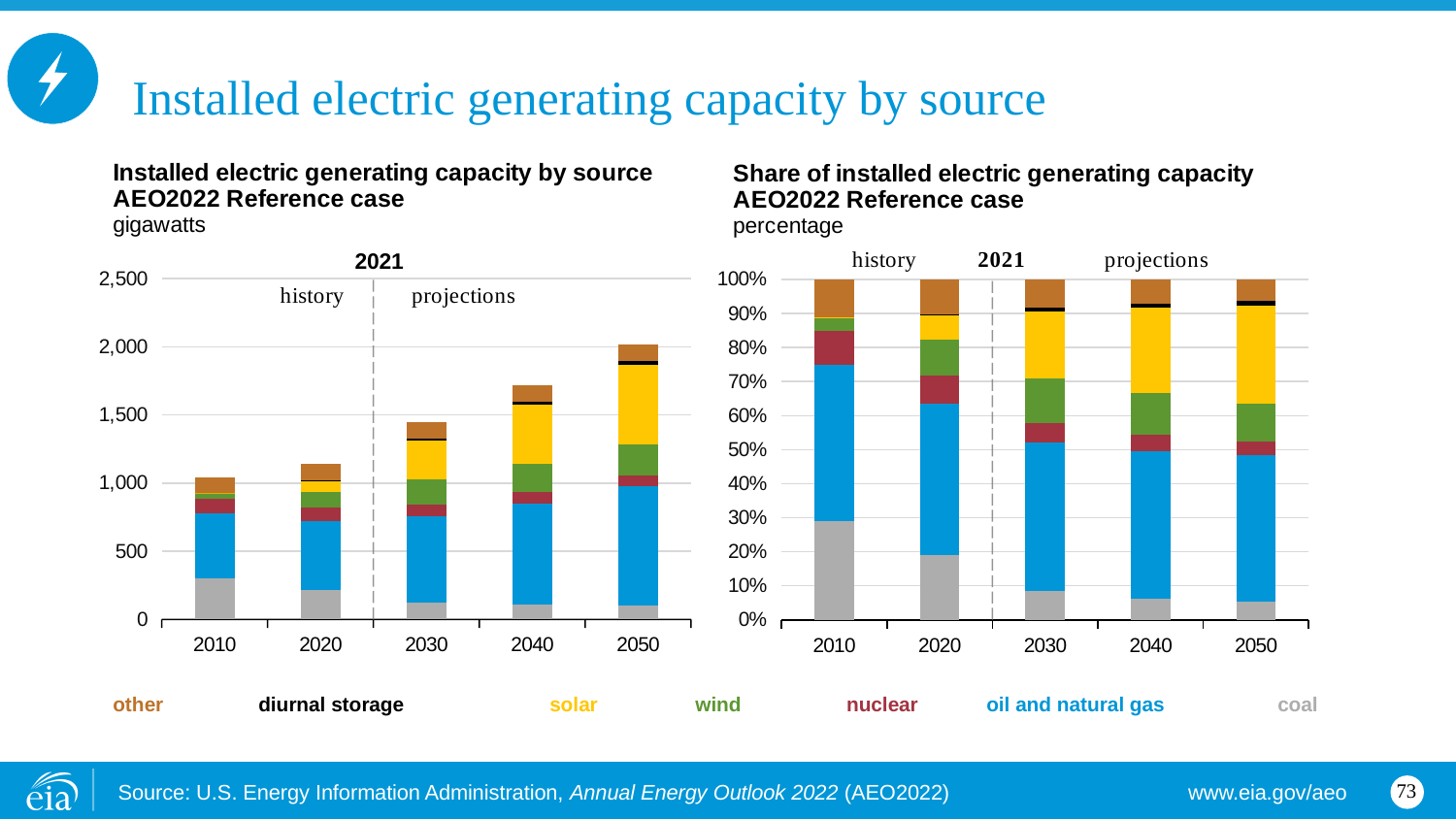
In the left chart, 'Installed electric generating capacity by source', which year has the tallest total bar? 2050 How many years are shown on the x axis of the left chart, 'Installed electric generating capacity by source'? 5 In the left chart, 'Installed electric generating capacity by source', is the total for 2030 greater or less than 1,500? less What kind of chart is the left chart, 'Installed electric generating capacity by source'? stacked bar chart In the left chart, 'Installed electric generating capacity by source', which year has the shortest total bar? 2010 In the left chart, 'Installed electric generating capacity by source', do the total bars rise or fall from 2010 to 2050? rise In the left chart, 'Installed electric generating capacity by source', is the total for 2050 greater or less than 1,500? greater What unit is given under the title of the left chart? gigawatts How many sources does the shared legend list? 7 In the right chart, 'Share of installed electric generating capacity', is the coal share in 2050 greater or less than 10%? less In the right chart, 'Share of installed electric generating capacity', does the coal share rise or fall from 2010 to 2050? fall In the right chart, 'Share of installed electric generating capacity', which year has the largest coal share? 2010